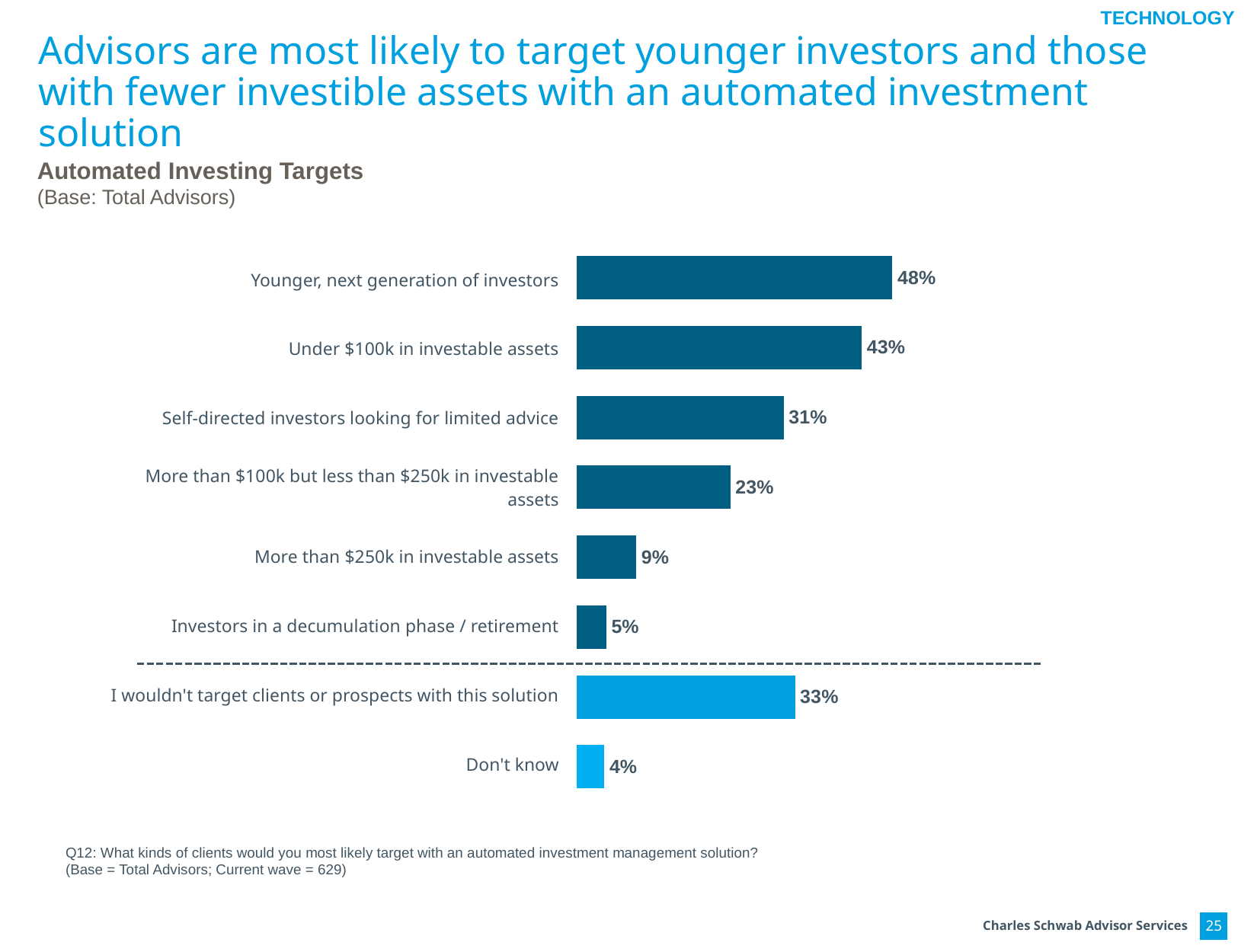
What is the title of the chart? Automated Investing Targets What is the value for 'Investors in a decumulation phase / retirement'? 5% What is the difference between the values for 'Younger, next generation of investors' and 'Under $100k in investable assets'? 5% What percentage of advisors said they wouldn't target clients or prospects with this solution? 33% Which category has the highest value in the chart? Younger, next generation of investors What percentage of advisors would target younger, next generation of investors with an automated investment solution? 48% Which is larger: the value for 'Self-directed investors looking for limited advice' or the value for 'I wouldn't target clients or prospects with this solution'? I wouldn't target clients or prospects with this solution What is the value for 'Under $100k in investable assets'? 43% Which category has the lowest value in the chart? Don't know What is the difference between 'More than $100k but less than $250k in investable assets' and 'More than $250k in investable assets'? 14% What kind of chart is shown on the slide? Bar chart How many categories are shown in the chart? 8